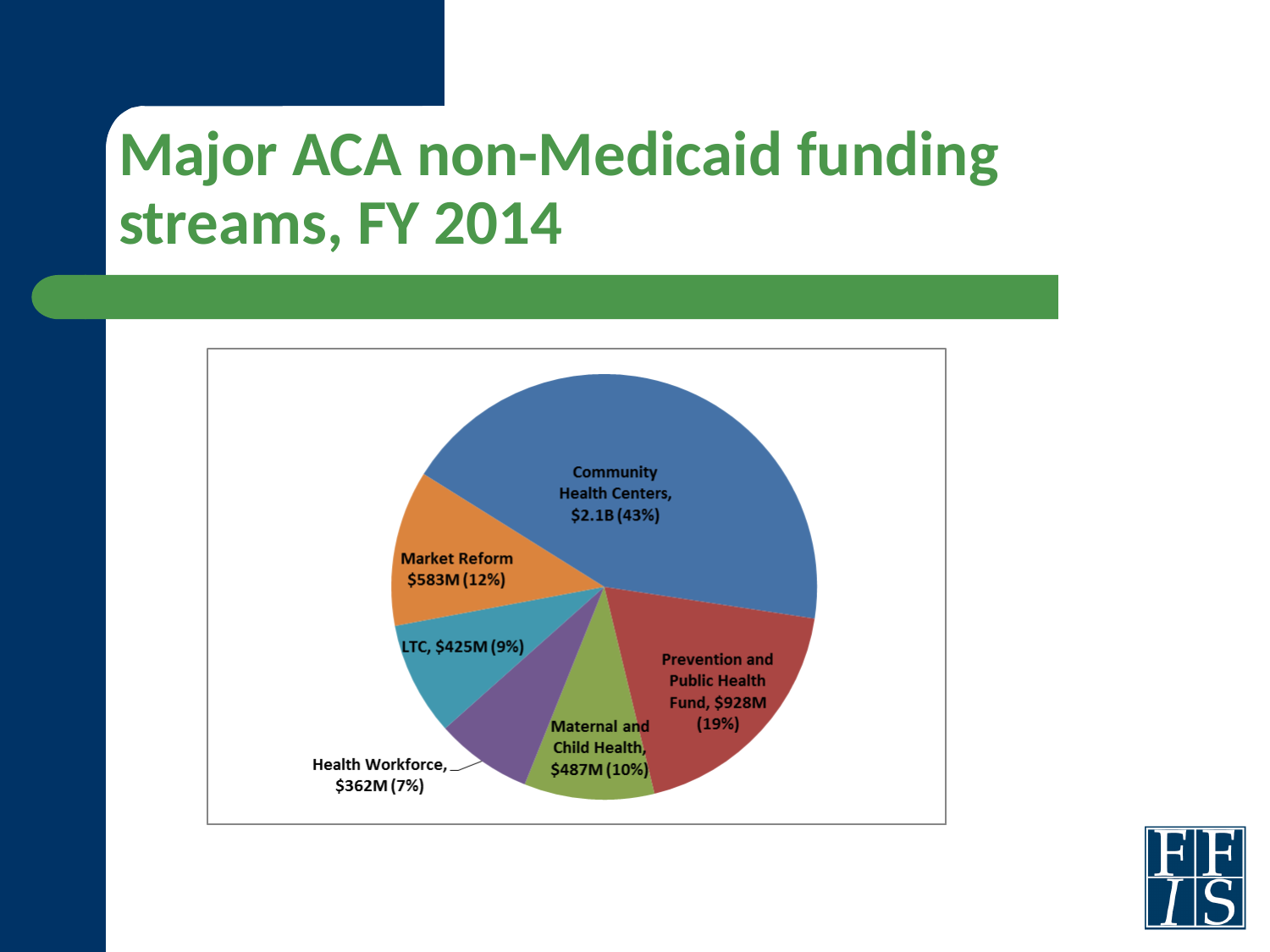
What kind of chart is shown on the slide? pie chart What is the funding amount for Community Health Centers? $2.1B Which funding stream is the largest? Community Health Centers What is the funding amount for the Prevention and Public Health Fund? $928M What is the funding amount for Market Reform? $583M What share of the pie does Maternal and Child Health represent? 10% What share of the pie does LTC represent? 9% How many slices does the pie chart have? 6 Which is larger, the Prevention and Public Health Fund or Maternal and Child Health? Prevention and Public Health Fund What is the difference in funding between Market Reform and LTC? $158M Which funding stream is the smallest? Health Workforce What is the funding amount for Health Workforce? $362M